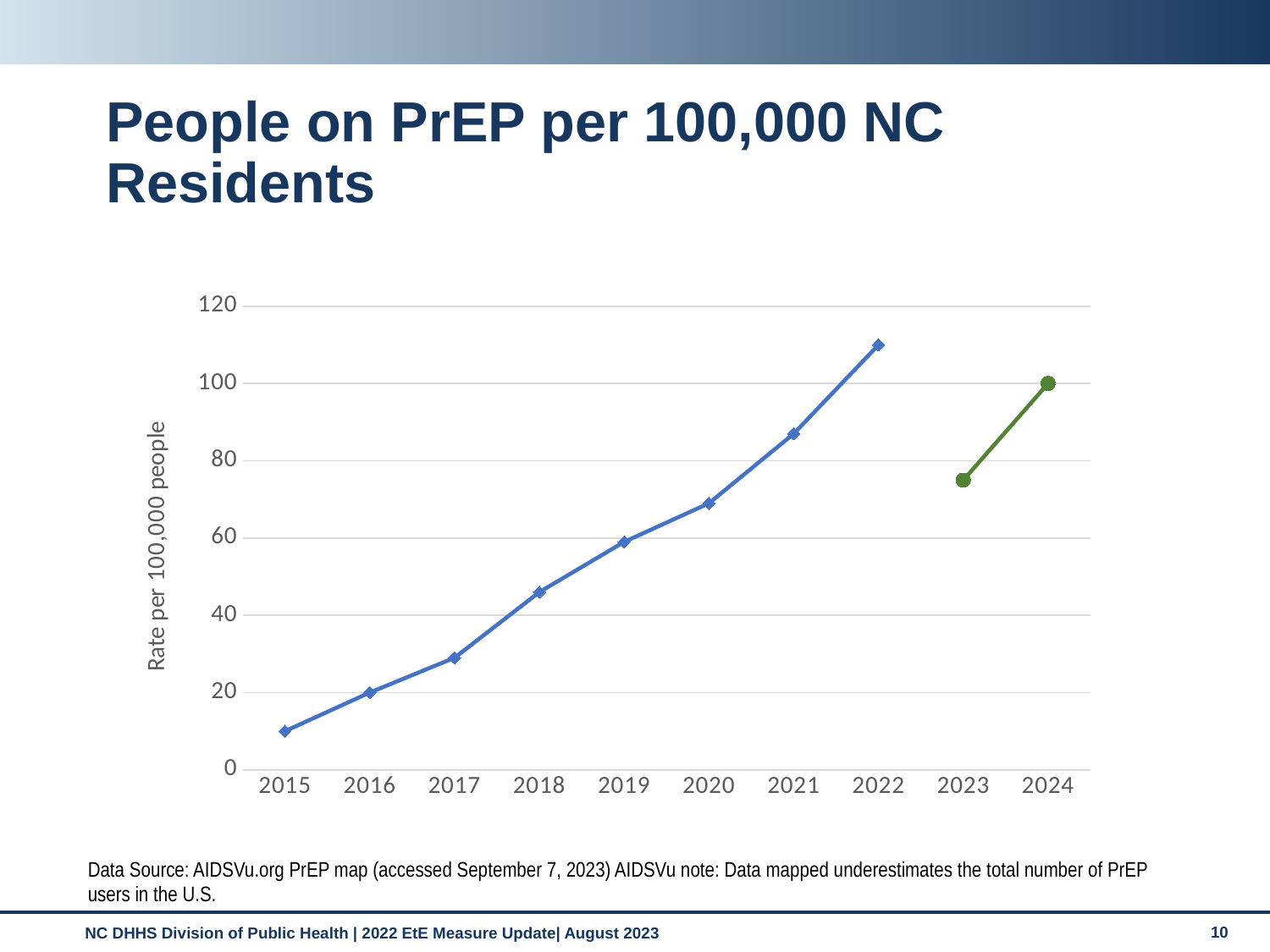
Is the value for 2022 greater or less than 100? greater Is the value for 2021 greater or less than 80? greater How many years are shown along the x axis of the chart? 10 Is the value for 2017 greater or less than 40? less What is the label on the y axis of the chart? Rate per 100,000 people Which year has the lowest rate of people on PrEP per 100,000 NC residents? 2015 Which year has the highest rate of people on PrEP per 100,000 NC residents? 2022 Which is larger, the value for 2022 or the value for 2024? 2022 Do the values rise or fall from 2015 to 2022? rise What kind of chart is shown on the slide? line chart